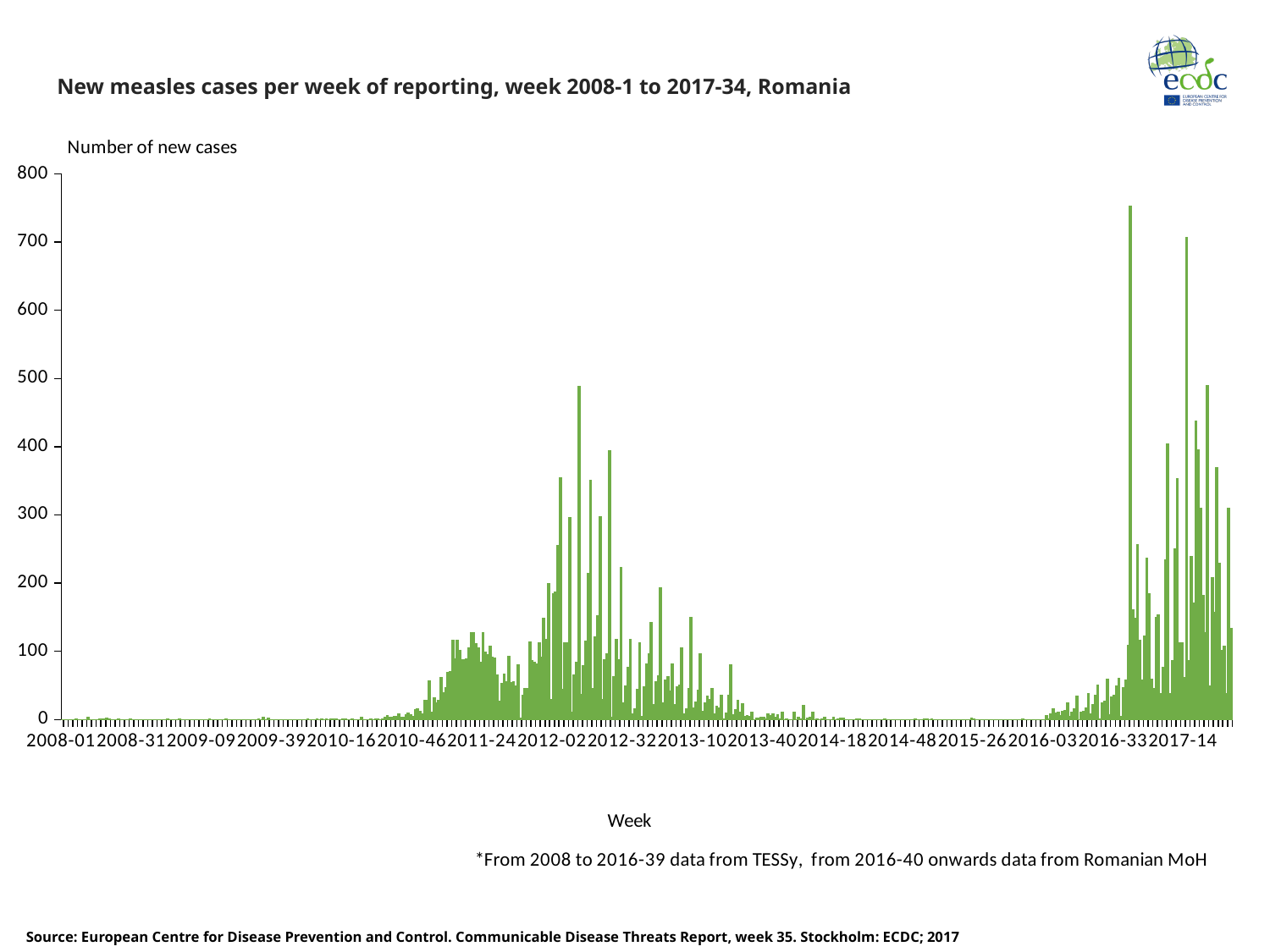
Is the tallest bar in the chart greater or less than 800? less What kind of chart is shown on the slide? bar chart Is the tallest bar in the 2012 outbreak period (around 2012-02) greater or less than 400? greater Is the tallest bar in the 2012 outbreak period (around 2012-02) greater or less than 500? less What is the label of the vertical axis? Number of new cases What is the highest value shown on the vertical axis? 800 What is the title of the chart? New measles cases per week of reporting, week 2008-1 to 2017-34, Romania How many week labels are printed along the horizontal axis? 17 Which period has the taller peak: around 2012-02 or around 2016-33 to 2017-14? around 2016-33 to 2017-14